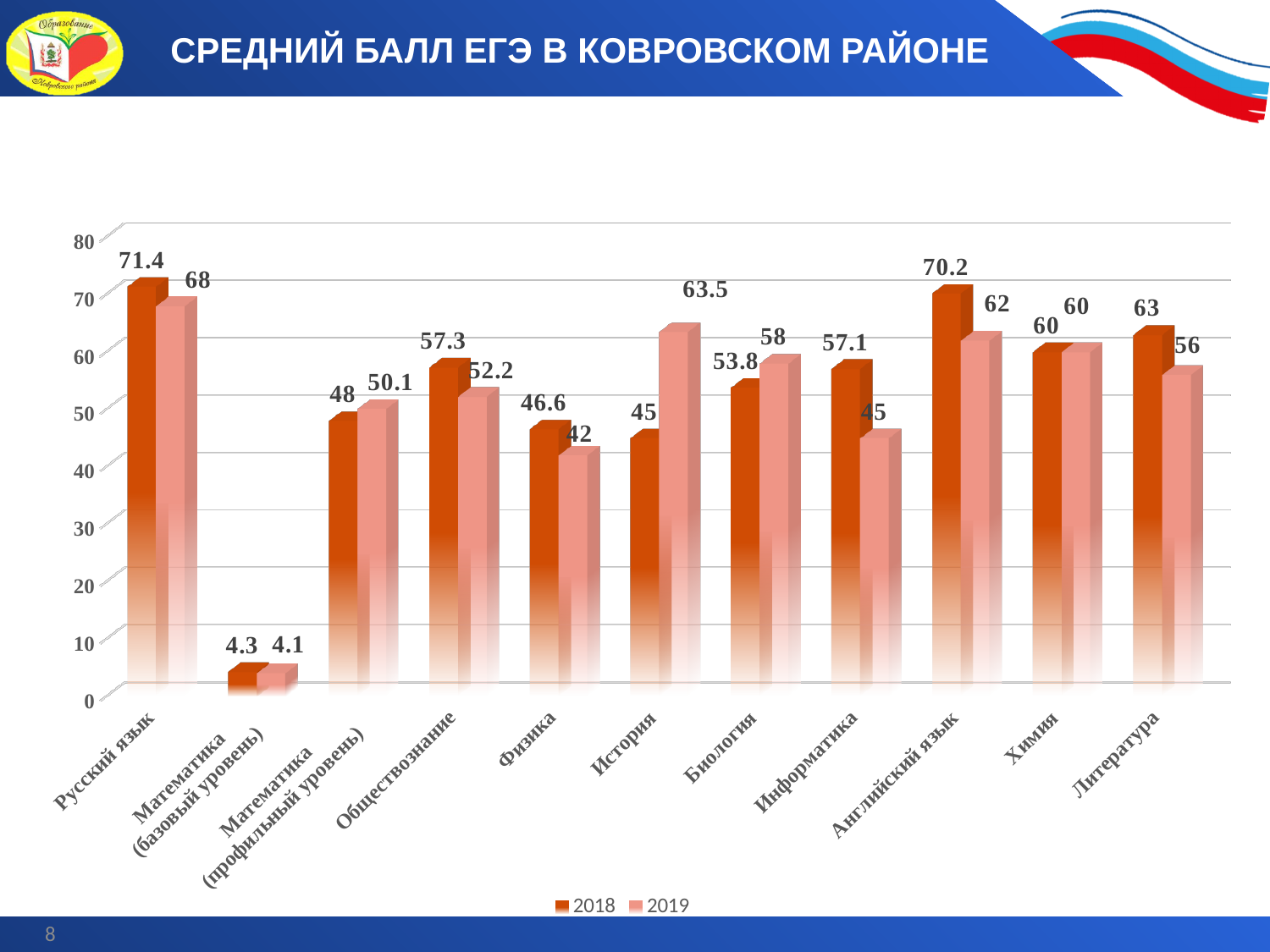
What was the average score for Русский язык in 2018? 71.4 Is the 2019 value for Физика greater or less than 50? less What was the average score for Информатика in 2019? 45 What kind of chart is shown on the slide? bar chart Which is larger for Биология: the 2018 score or the 2019 score? 2019 Which subject had the lowest average score in 2019? Математика (базовый уровень) How many subjects are shown on the x axis? 11 What are the two series listed in the legend? 2018 and 2019 What is the difference between the 2018 and 2019 scores for Английский язык? 8.2 How many series does the legend list? 2 Which subject had the highest average score in 2018? Русский язык What was the average score for История in 2019? 63.5